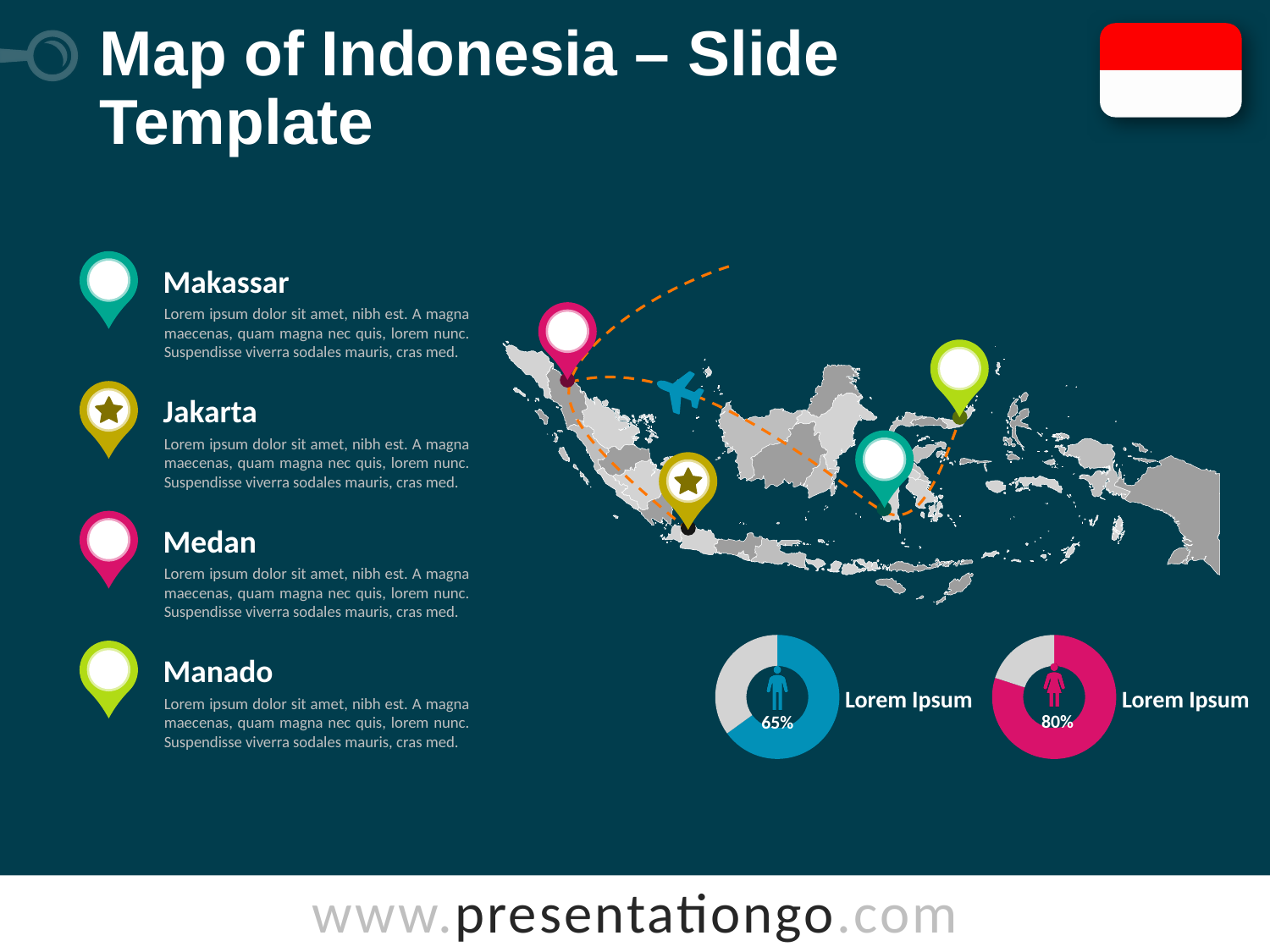
Which donut chart shows the higher percentage, the left (blue) one or the right (pink) one? the right (pink) one Is the value shown in the left (blue) donut chart greater or less than 50%? greater Which donut chart shows the lower percentage? the left (blue) one What kind of chart is used to display the 65% and 80% values at the bottom right of the slide? donut chart What percentage is shown in the left donut chart (with the blue segment)? 65% What is the difference between the percentages shown in the right (pink) donut chart and the left (blue) donut chart? 15% What percentage is shown in the right donut chart (with the pink segment)? 80% What label appears next to the left (blue) donut chart? Lorem Ipsum What colour is the filled segment of the right donut chart showing 80%? pink Is the value shown in the right (pink) donut chart greater or less than 75%? greater How many donut charts are shown on the slide? 2